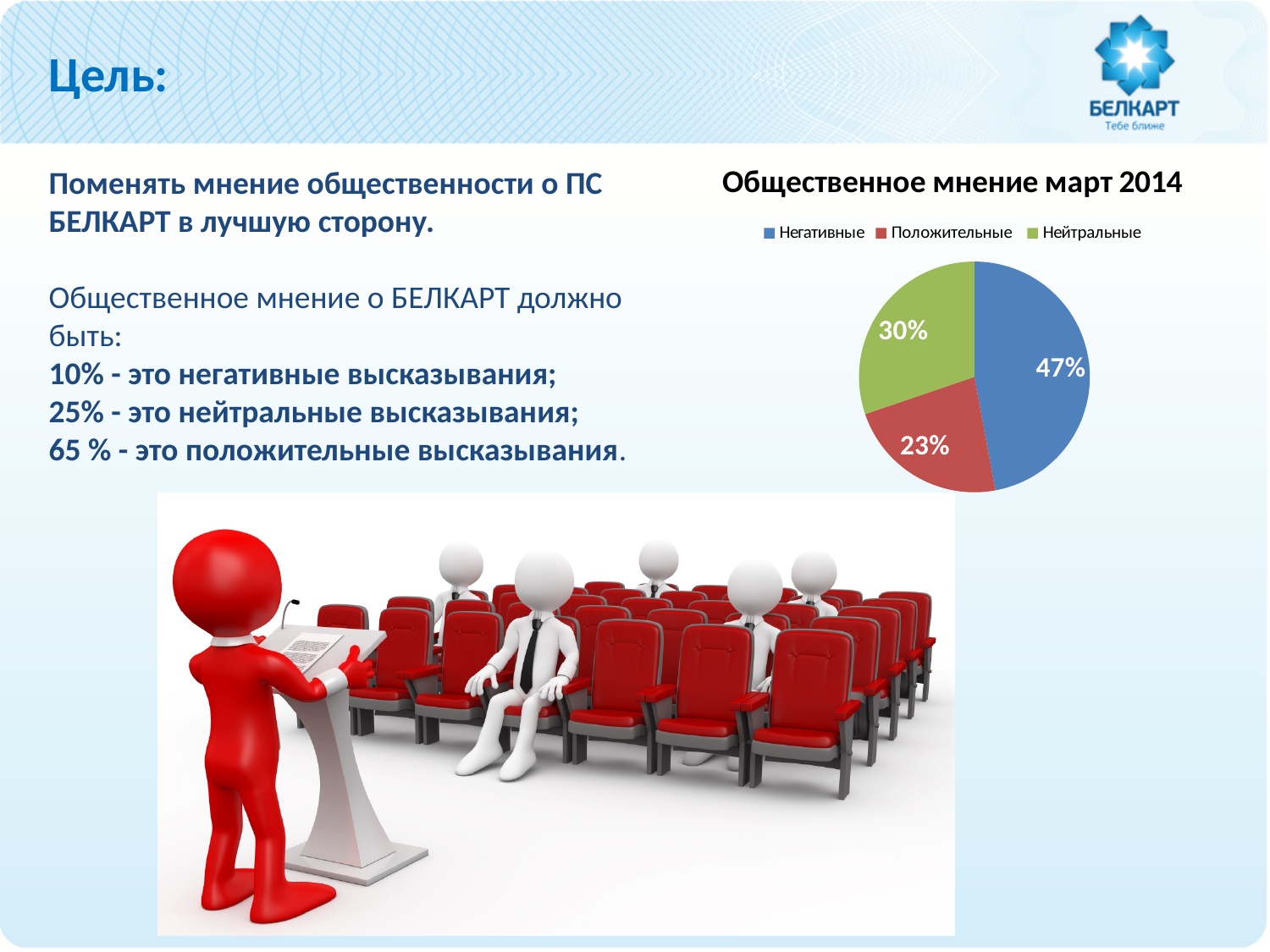
What colour is the Нейтральные slice? green How many categories does the legend list? 3 Which is larger, the Нейтральные slice or the Положительные slice? Нейтральные What share of the pie is labelled Негативные? 47% Which category has the largest slice of the pie? Негативные What kind of chart is shown on the slide? pie chart What is the title of the chart? Общественное мнение март 2014 What share of the pie is labelled Нейтральные? 30% What is the difference between the Нейтральные and Положительные shares? 7% Which category has the smallest slice of the pie? Положительные What is the difference between the Негативные and Положительные shares? 24% What share of the pie is labelled Положительные? 23%